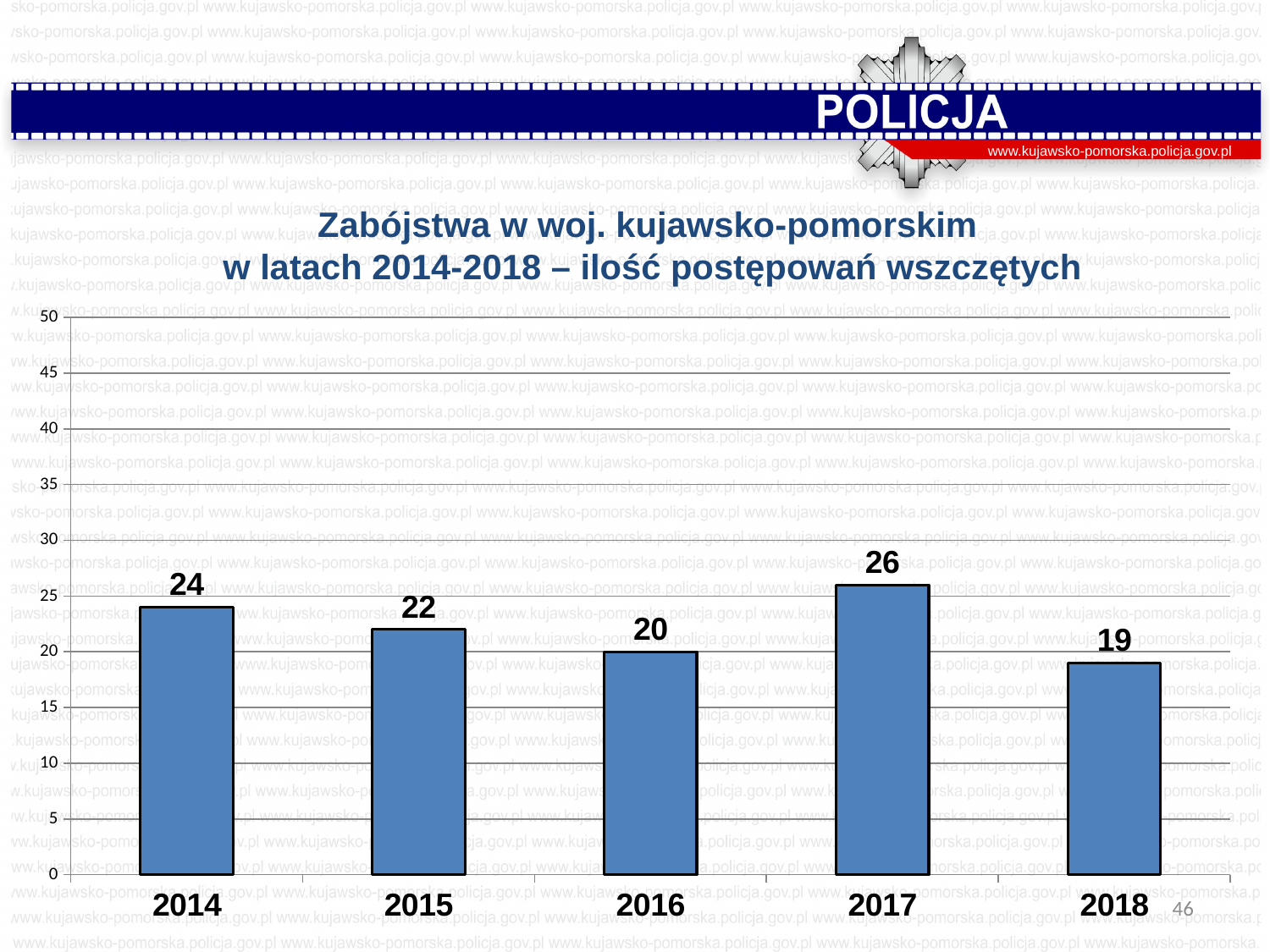
Is the value for 2017 greater or less than 25? greater What is the value for 2016? 20 What is the title of the chart? Zabójstwa w woj. kujawsko-pomorskim w latach 2014-2018 – ilość postępowań wszczętych What is the value for 2014? 24 Do the values rise or fall from 2014 to 2016? fall Which year has the highest value? 2017 What is the difference between the values for 2017 and 2018? 7 Which is larger, the value for 2015 or the value for 2016? 2015 Which year has the lowest value? 2018 What kind of chart is shown on the slide? bar chart How many years are shown on the x axis? 5 What is the value for 2018? 19